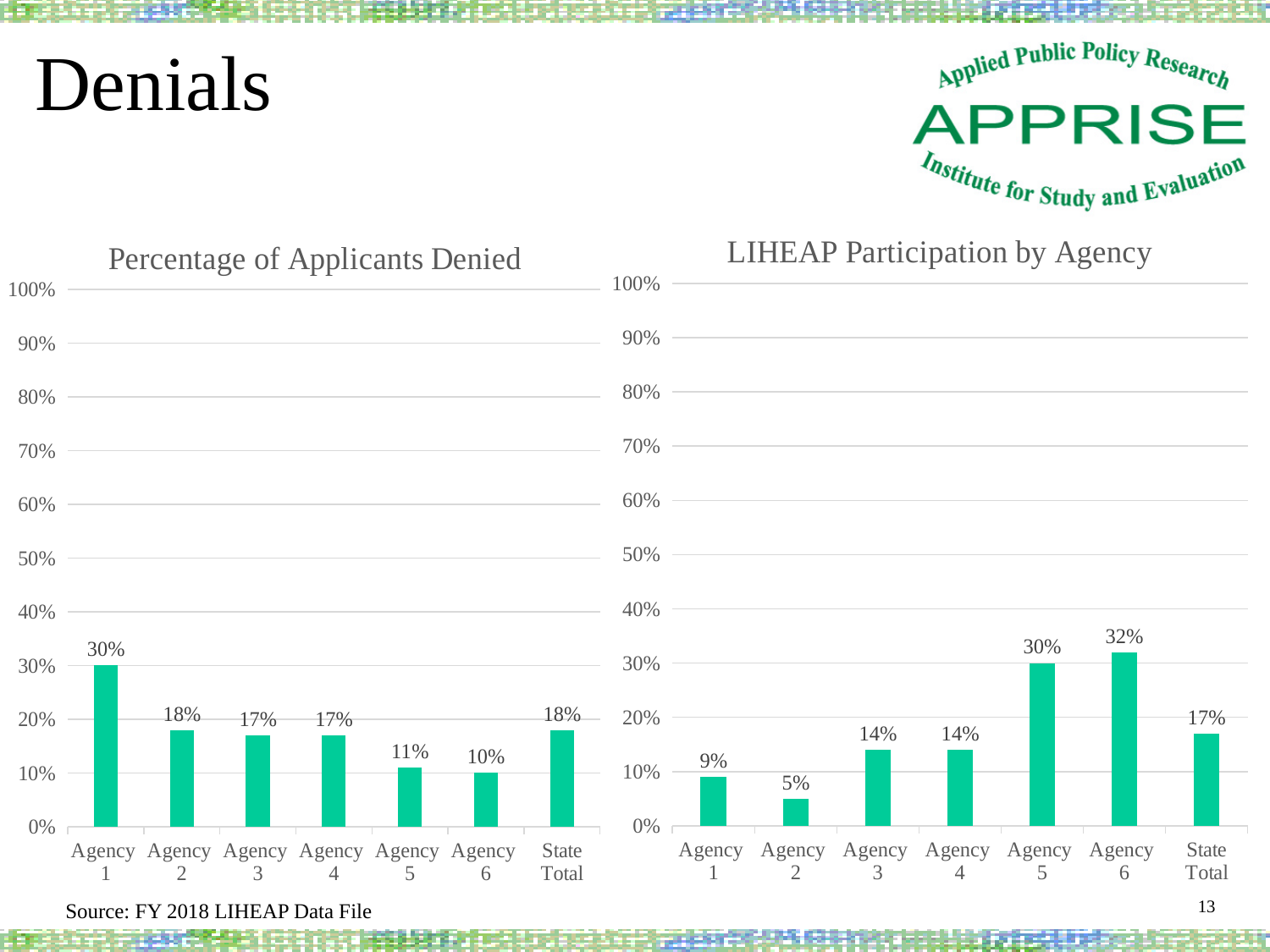
How many categories are shown in the 'LIHEAP Participation by Agency' chart? 7 In the 'LIHEAP Participation by Agency' chart, what is the value for Agency 2? 5% In the 'Percentage of Applicants Denied' chart, what is the value for State Total? 18% In the 'LIHEAP Participation by Agency' chart, which is larger, Agency 1 or Agency 3? Agency 3 In the 'Percentage of Applicants Denied' chart, is the value for Agency 1 greater or less than 20%? greater What is the title of the chart on the right side of the slide? LIHEAP Participation by Agency What kind of chart is the 'Percentage of Applicants Denied' chart? Bar chart In the 'Percentage of Applicants Denied' chart, what is the value for Agency 1? 30% In the 'LIHEAP Participation by Agency' chart, what is the difference between Agency 6 and State Total? 15% In the 'Percentage of Applicants Denied' chart, which category has the lowest value? Agency 6 In the 'LIHEAP Participation by Agency' chart, which category has the highest value? Agency 6 In the 'Percentage of Applicants Denied' chart, what is the difference between Agency 1 and Agency 5? 19%